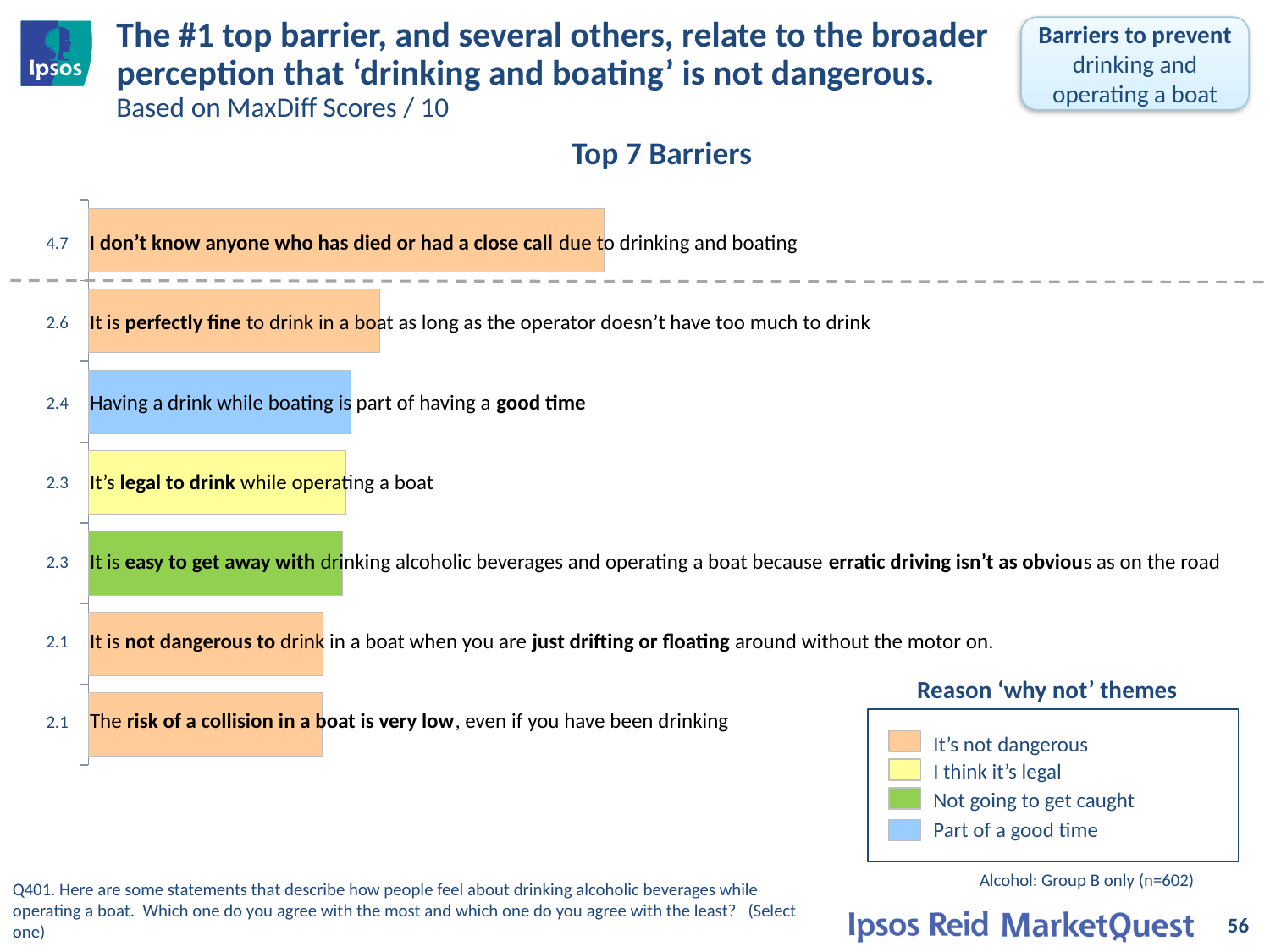
Which has a higher score: "Having a drink while boating is part of having a good time" or "It's legal to drink while operating a boat"? Having a drink while boating is part of having a good time How many 'why not' themes does the legend list? 4 What is the MaxDiff score for the barrier "I don't know anyone who has died or had a close call due to drinking and boating"? 4.7 Which theme does the green bar represent according to the legend? Not going to get caught What is the score for "The risk of a collision in a boat is very low, even if you have been drinking"? 2.1 What is the difference between the top barrier's score (4.7) and the second barrier's score (2.6)? 2.1 What is the score for "Having a drink while boating is part of having a good time"? 2.4 Which barrier has the highest MaxDiff score? I don't know anyone who has died or had a close call due to drinking and boating What type of chart is used to show the Top 7 Barriers? Bar chart What is the score for "It is perfectly fine to drink in a boat as long as the operator doesn't have too much to drink"? 2.6 How many barriers are shown in the Top 7 Barriers chart? 7 What is the score for "It's legal to drink while operating a boat"? 2.3